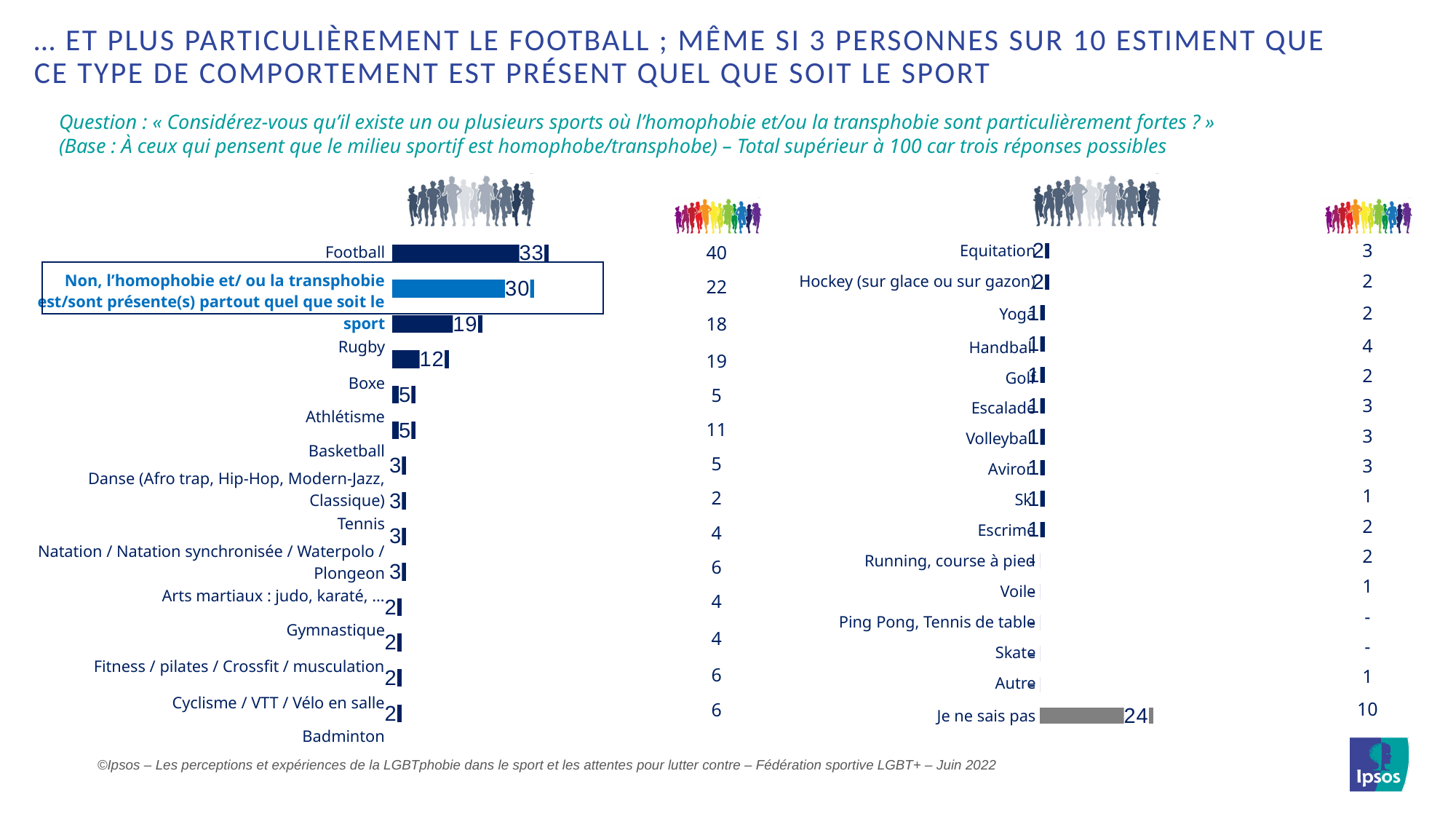
In the left chart, which category has the highest value? Football In the left chart, what is the value for the highlighted category 'Non, l'homophobie et/ou la transphobie est/sont présente(s) partout quel que soit le sport'? 30 How many categories are listed in the right chart? 16 In the left chart, what is the value for Rugby? 19 In the right chart, what is the difference between the values for 'Je ne sais pas' and Equitation? 22 In the right chart, what is the value for Equitation? 2 In the right chart, what is the value for 'Je ne sais pas'? 24 What type of chart is the left chart? Bar chart In the left chart, what is the value for Football? 33 In the right chart, which category has the highest value? Je ne sais pas In the left chart, what is the difference between the values for Football and Rugby? 14 In the left chart, which is larger, the value for Football or the value for Rugby? Football